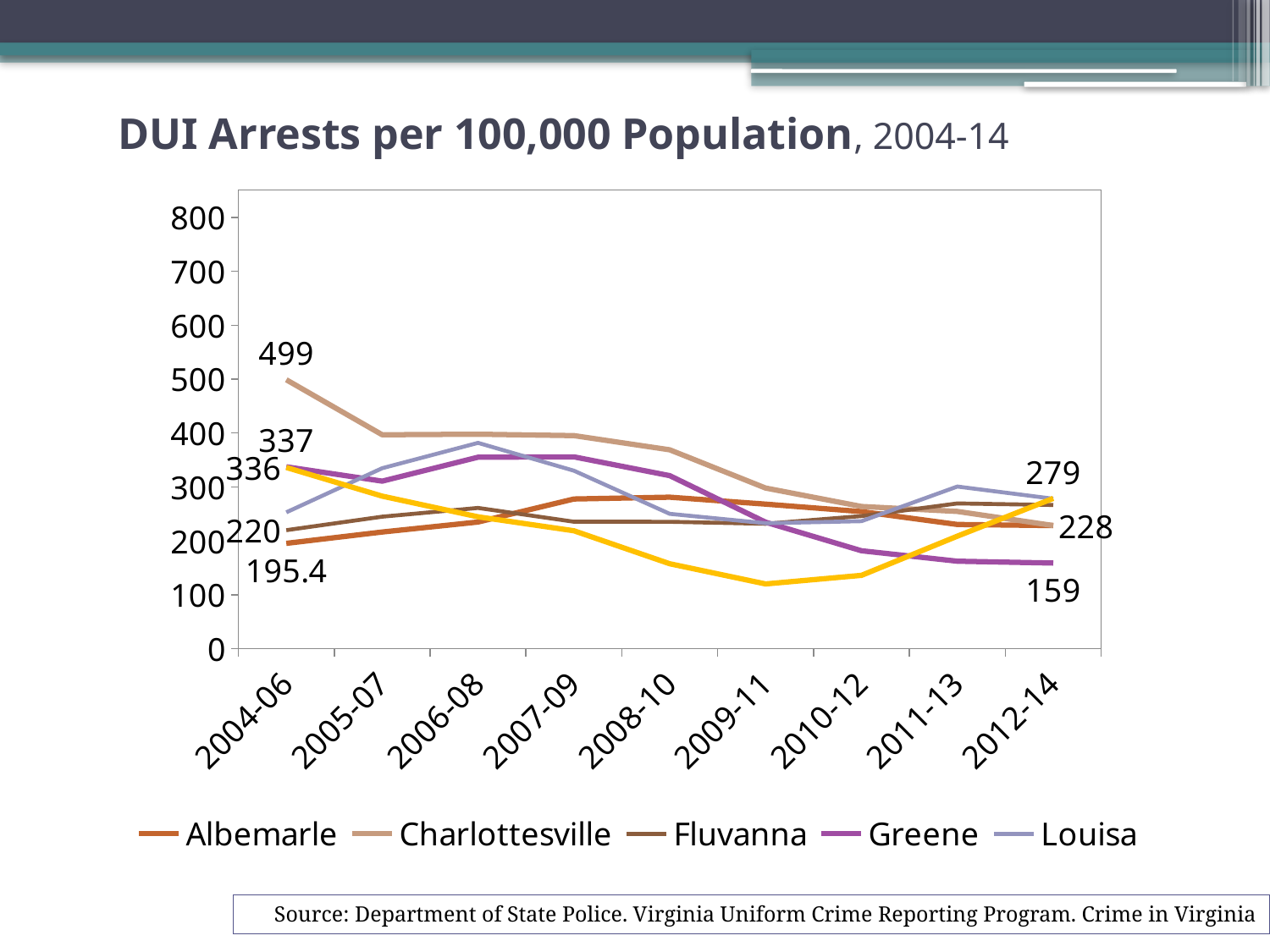
How many time periods are shown along the x axis? 9 Which locality has the lowest DUI arrest rate in 2012-14? Greene What is the DUI arrest rate for Fluvanna in 2004-06? 220 What kind of chart is shown on the slide? line chart What is the DUI arrest rate for Greene in 2012-14? 159 Is the value for Louisa in 2011-13 greater or less than 200? greater How many series does the legend list? 5 What is the DUI arrest rate for Albemarle in 2004-06? 195.4 Which locality has the highest DUI arrest rate in 2004-06? Charlottesville How much higher is Charlottesville's rate than Albemarle's in 2004-06? 303.6 Does the Charlottesville line rise or fall from 2004-06 to 2012-14? fall What is the DUI arrest rate for Charlottesville in 2004-06? 499